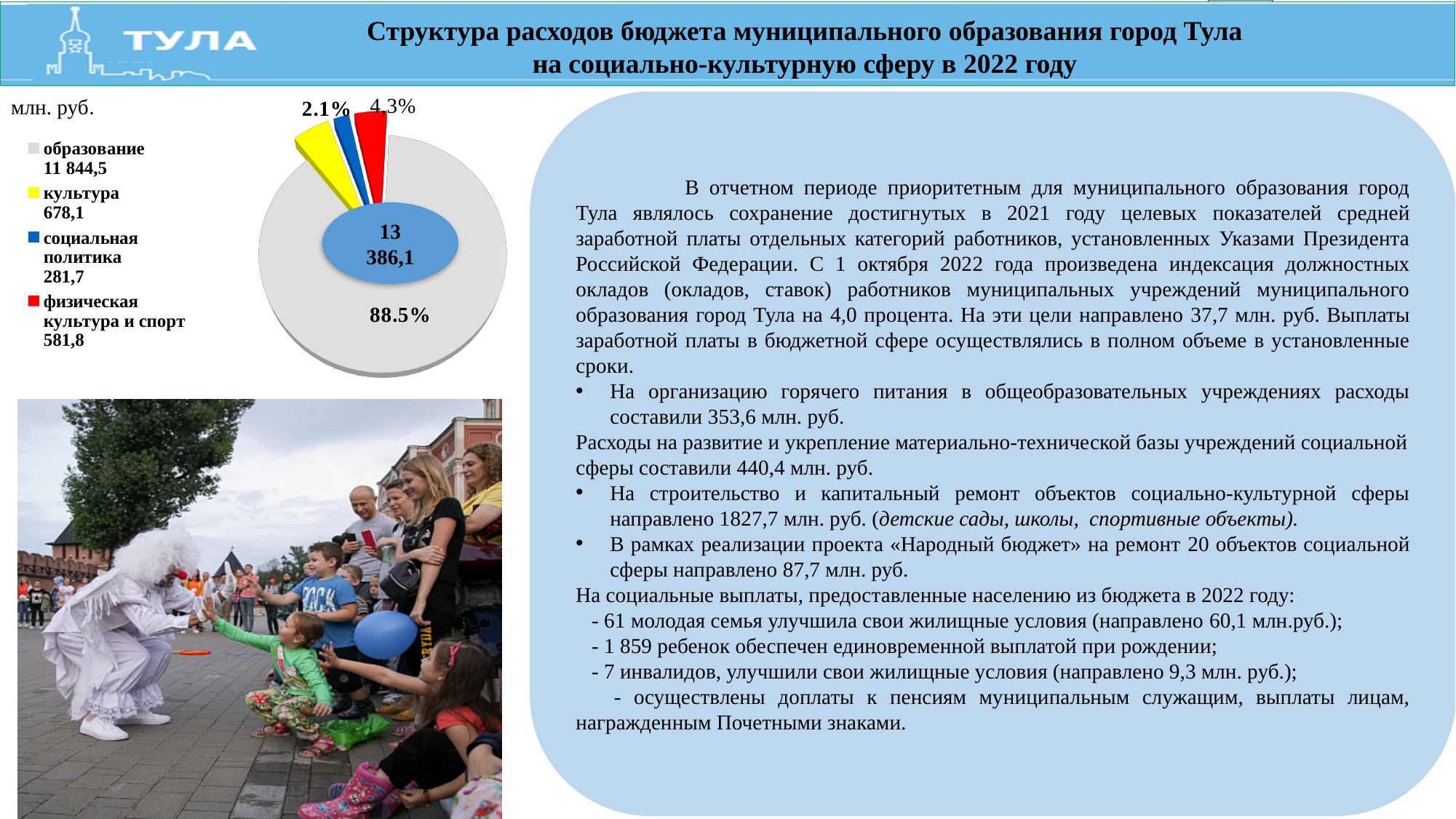
Which category has the smallest share of the pie chart? социальная политика What total value is printed in the centre of the pie chart? 13 386,1 What is the value for культура in the pie chart? 678,1 Which is larger in the pie chart: культура or физическая культура и спорт? культура What is the value for физическая культура и спорт in the pie chart? 581,8 What is the value for образование in the pie chart? 11 844,5 How many categories does the pie chart's legend list? 4 Which category has the largest share of the pie chart? образование What is the value for социальная политика in the pie chart? 281,7 What is the difference between the values for культура and социальная политика? 396,4 What share of the pie does образование account for? 88.5% What kind of chart is shown on the slide? pie chart